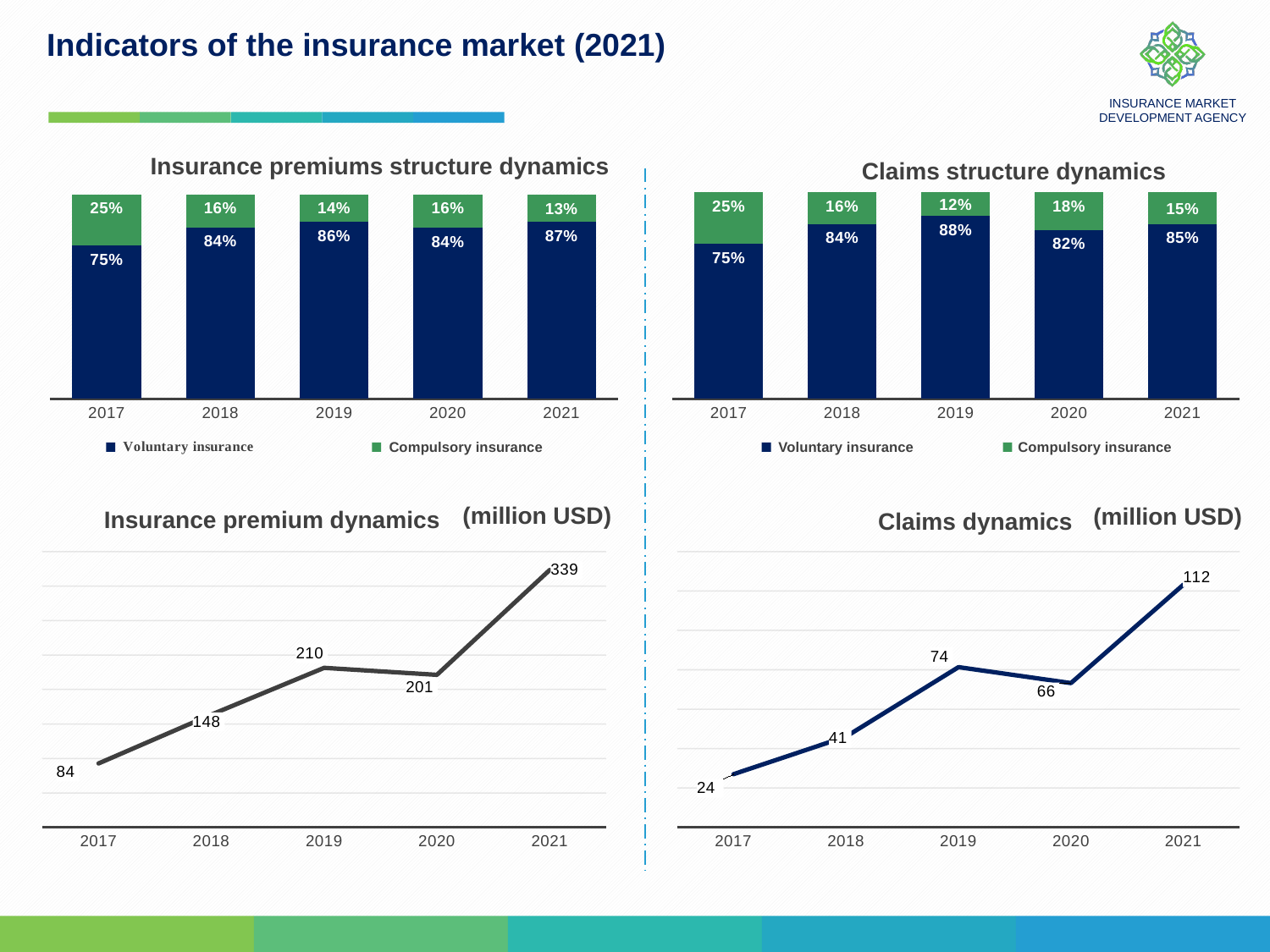
In the 'Insurance premium dynamics' chart, what is the difference between the 2021 and 2017 values? 255 In the 'Claims dynamics' chart, which is larger, the value for 2019 or the value for 2020? 2019 How many series does the legend of the 'Insurance premiums structure dynamics' chart list? 2 In the 'Claims structure dynamics' chart, what is the total of the stacked bar for 2021? 100% In the 'Insurance premium dynamics' chart, what is the value for 2020? 201 In the 'Insurance premium dynamics' chart, which year has the highest value? 2021 In the 'Insurance premiums structure dynamics' chart, what is the Voluntary insurance share in 2019? 86% What kind of chart is 'Claims dynamics'? Line chart In the 'Claims dynamics' chart, what is the value for 2018? 41 How many years are shown on the x axis of the 'Claims structure dynamics' chart? 5 In the 'Claims structure dynamics' chart, what is the Compulsory insurance share in 2020? 18% In the 'Claims dynamics' chart, which year has the lowest value? 2017